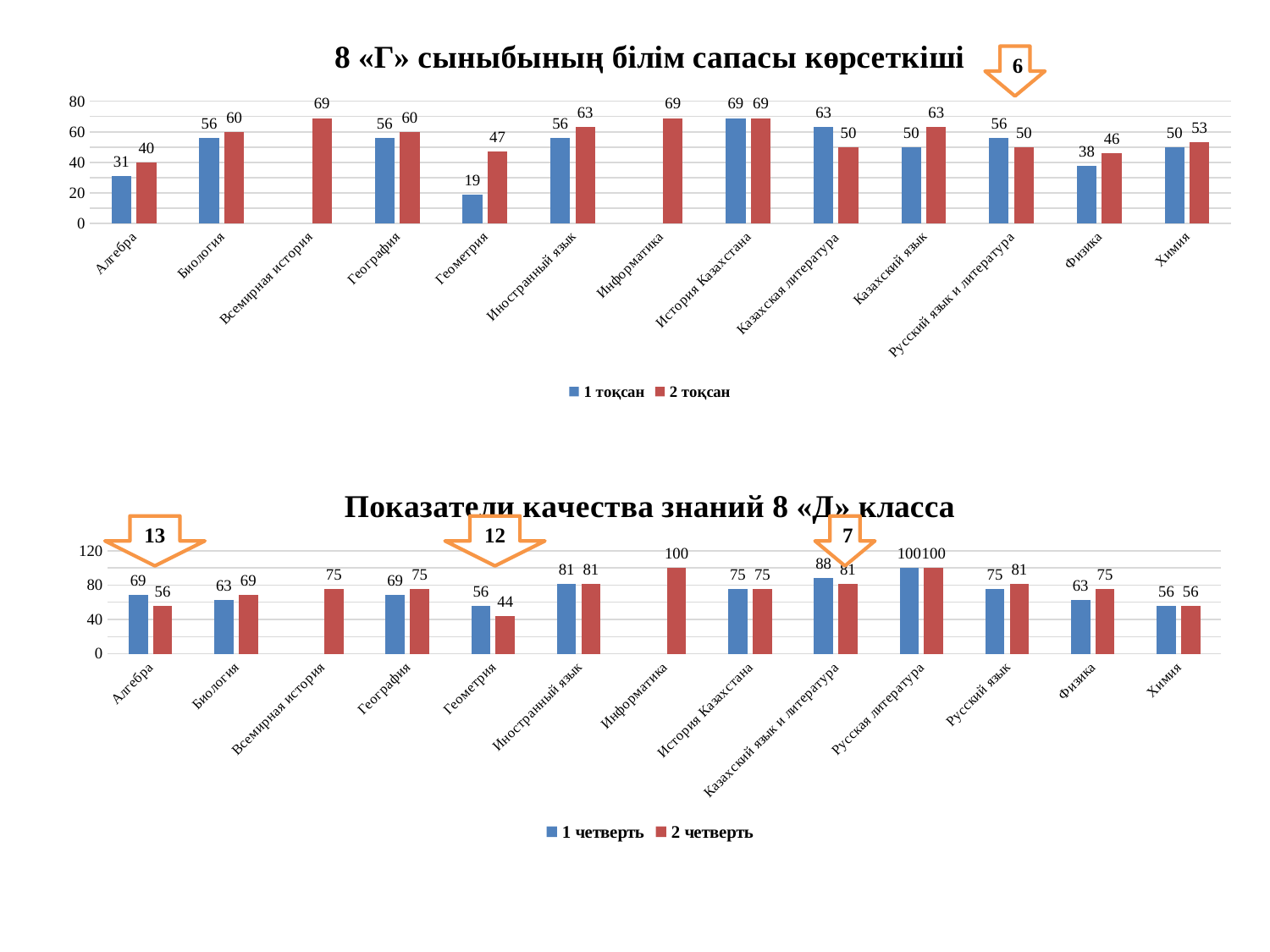
In the top chart (8 «Г» сыныбының білім сапасы көрсеткіші), what is the value for Физика in the 2 тоқсан series? 46 In the top chart (8 «Г» сыныбының білім сапасы көрсеткіші), how many series does the legend list? 2 In the bottom chart (Показатели качества знаний 8 «Д» класса), what is the value for Информатика in the 2 четверть series? 100 In the bottom chart (Показатели качества знаний 8 «Д» класса), what is the value for Казахский язык и литература in the 1 четверть series? 88 In the bottom chart (Показатели качества знаний 8 «Д» класса), how many categories are shown on the x axis? 13 In the top chart (8 «Г» сыныбының білім сапасы көрсеткіші), what is the difference between the 2 тоқсан and 1 тоқсан values for Геометрия? 28 In the top chart (8 «Г» сыныбының білім сапасы көрсеткіші), what is the value for Геометрия in the 1 тоқсан series? 19 What type of chart is the bottom chart (Показатели качества знаний 8 «Д» класса)? Bar chart In the bottom chart (Показатели качества знаний 8 «Д» класса), what is the difference between the 1 четверть and 2 четверть values for Алгебра? 13 In the top chart (8 «Г» сыныбының білім сапасы көрсеткіші), which is larger for Казахская литература: the 1 тоқсан value or the 2 тоқсан value? 1 тоқсан In the top chart (8 «Г» сыныбының білім сапасы көрсеткіші), which category has the lowest 1 тоқсан value? Геометрия In the bottom chart (Показатели качества знаний 8 «Д» класса), which category has the lowest 2 четверть value? Геометрия